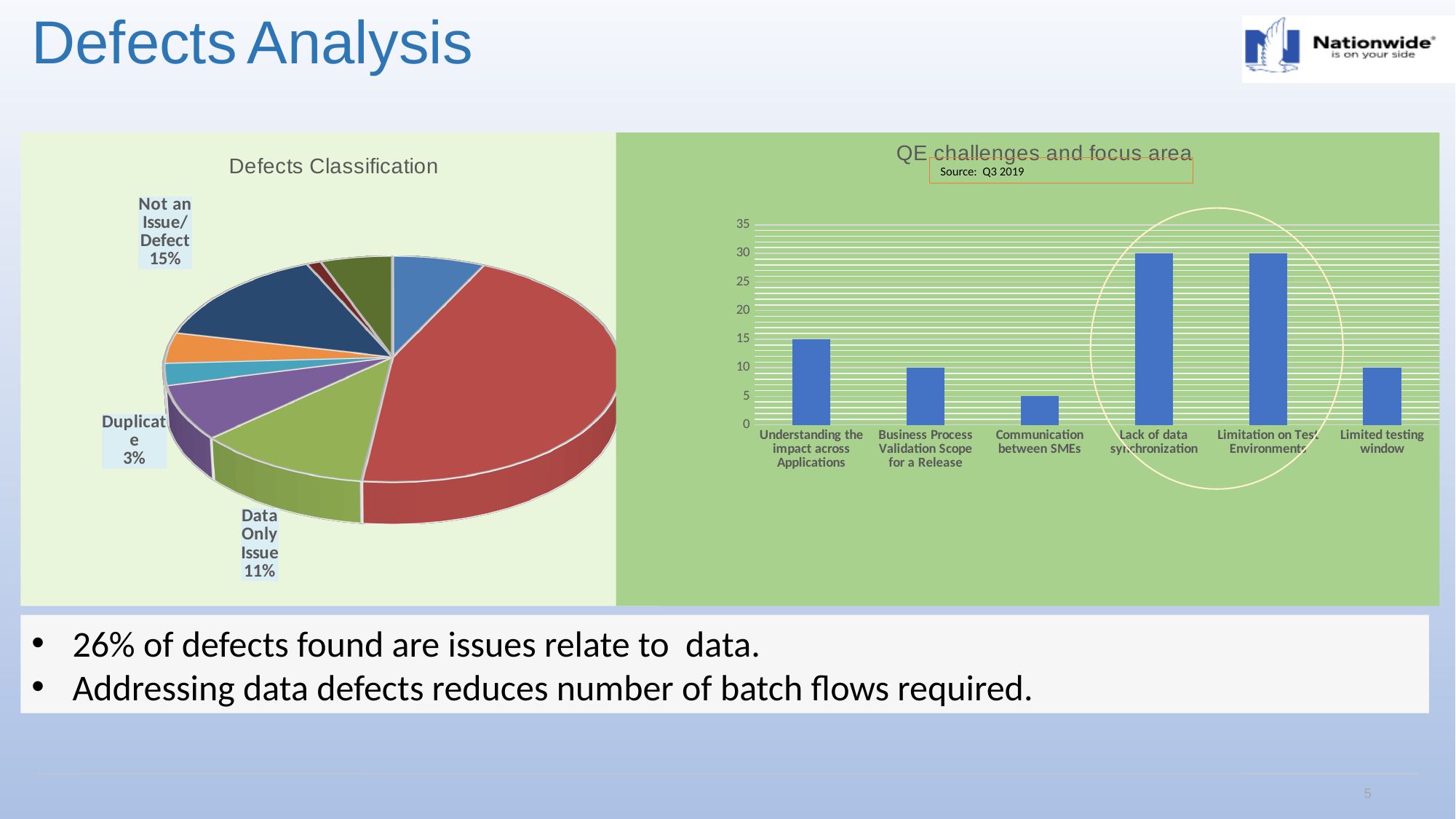
In the Defects Classification pie chart, what share is labelled for Data Only Issue? 11% In the QE challenges and focus area chart, is the value for Lack of data synchronization greater or less than 25? greater What source is cited on the QE challenges and focus area chart? Q3 2019 In the QE challenges and focus area chart, which is larger: Understanding the impact across Applications or Limited testing window? Understanding the impact across Applications In the Defects Classification pie chart, which is larger: the Not an Issue/Defect slice or the Data Only Issue slice? Not an Issue/Defect In the Defects Classification pie chart, what share is labelled for Duplicate? 3% In the Defects Classification pie chart, what is the difference in percentage points between the Not an Issue/Defect slice and the Data Only Issue slice? 4% How many categories are shown in the QE challenges and focus area chart? 6 In the QE challenges and focus area chart, which category has the lowest value? Communication between SMEs What kind of chart is the QE challenges and focus area chart? Bar chart What kind of chart is the Defects Classification chart? Pie chart In the Defects Classification pie chart, what share is labelled for Not an Issue/Defect? 15%